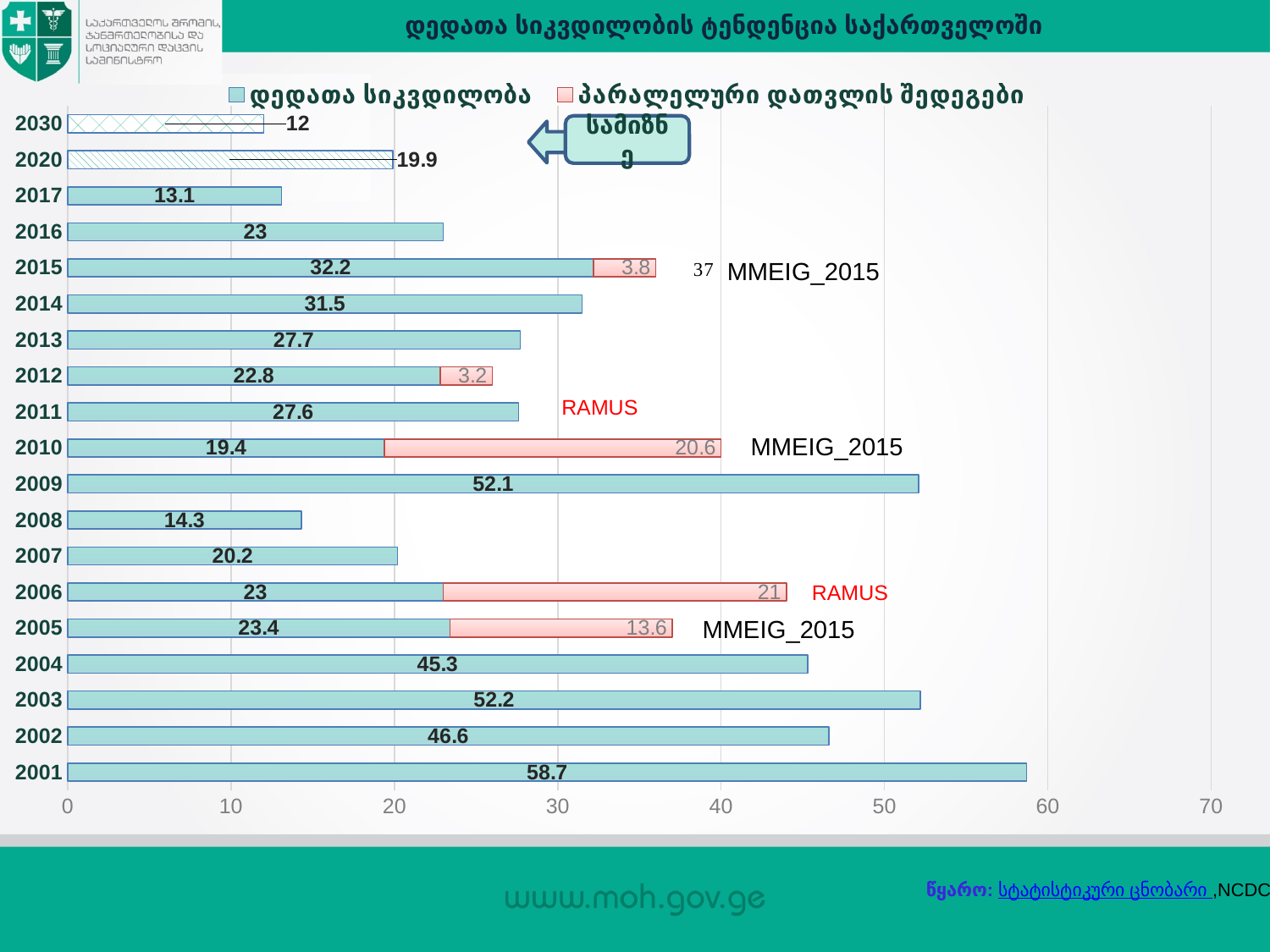
What is the parallel count (პარალელური დათვლის შედეგები) value shown for 2010? 20.6 What is the maternal mortality value shown for 2017? 13.1 Which year has the larger maternal mortality value, 2014 or 2013? 2014 Which year has the highest maternal mortality value? 2001 What is the total of the stacked bar for 2006? 44 What is the maternal mortality (დედათა სიკვდილობა) value shown for 2001? 58.7 How many years (categories) are shown on the chart? 19 What is the difference between the maternal mortality values for 2001 and 2017? 45.6 How many series does the legend list? 2 What kind of chart is shown on the slide? bar chart Is the maternal mortality value for 2009 greater or less than 50? greater